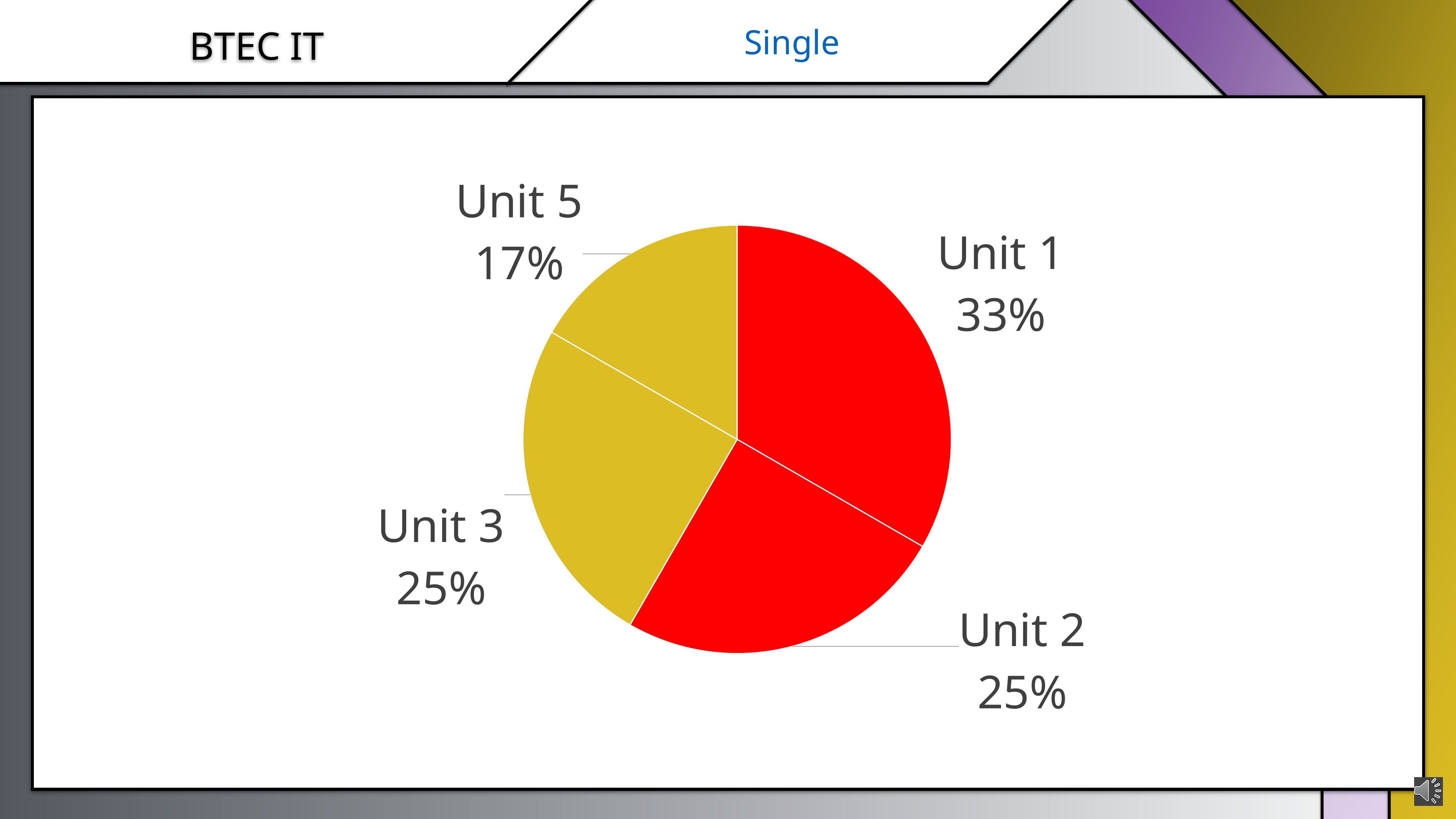
What share of the pie does Unit 5 have? 17% How many slices does the pie chart have? 4 Which is larger, the slice for Unit 1 or the slice for Unit 3? Unit 1 What is the difference in percentage points between Unit 1 and Unit 5? 16 What share of the pie does Unit 2 have? 25% What share of the pie does Unit 3 have? 25% What colour is the slice for Unit 5? yellow What colour is the slice for Unit 2? red Which unit has the smallest slice of the pie? Unit 5 Which unit has the largest slice of the pie? Unit 1 What kind of chart is shown on the slide? pie chart